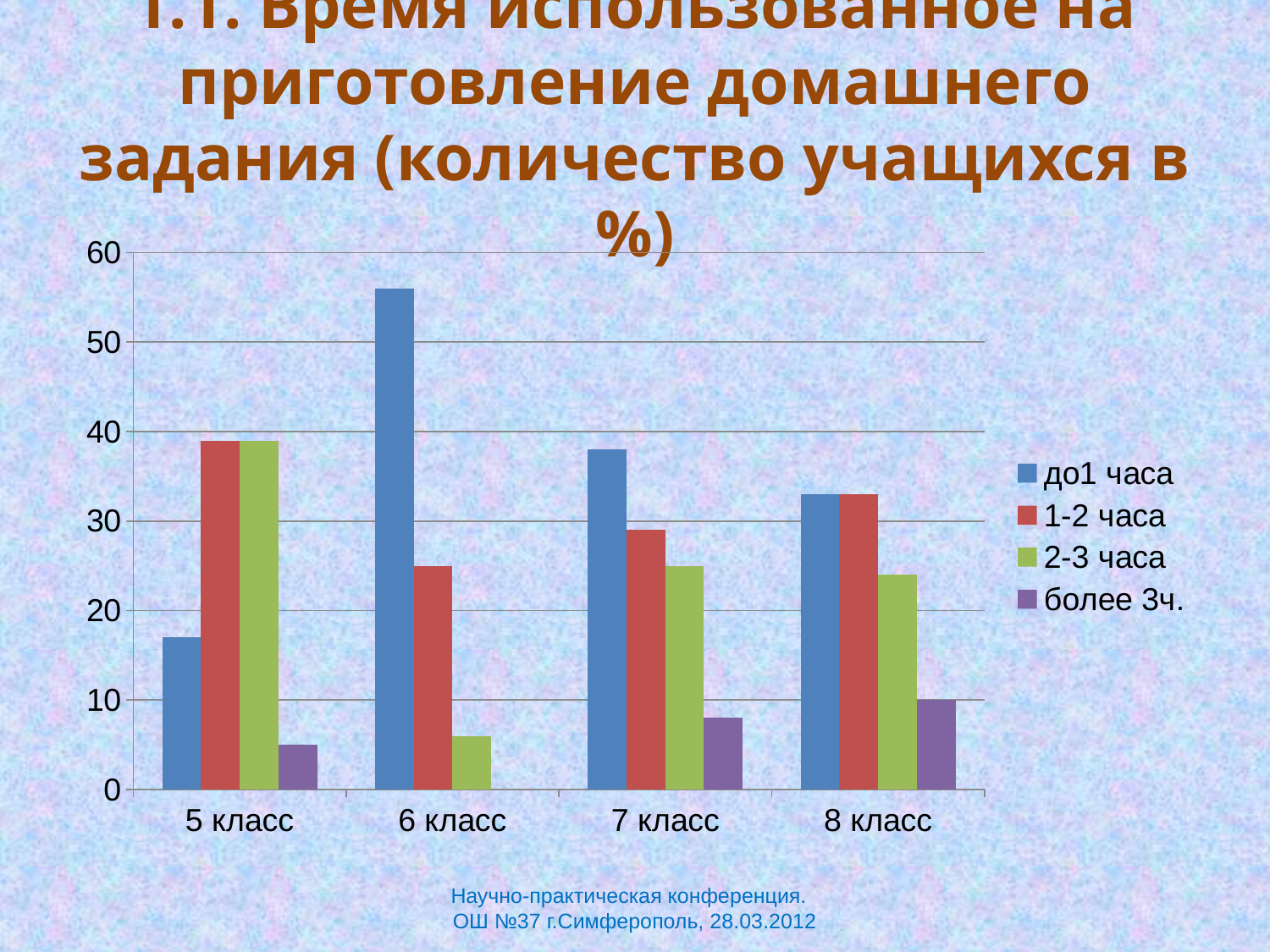
Is the value for "до1 часа" in 6 класс greater or less than 50? greater In 5 класс, which is larger: "до1 часа" or "1-2 часа"? 1-2 часа Which class has the lowest bar for "до1 часа"? 5 класс What kind of chart is shown on the slide? bar chart How many classes (categories) are shown on the x axis? 4 In 6 класс, which is larger: "до1 часа" or "1-2 часа"? до1 часа How many series does the legend list? 4 Which class has the lowest bar for "2-3 часа"? 6 класс Which class has the highest bar for "до1 часа"? 6 класс Is the value for "до1 часа" in 5 класс greater or less than 20? less Is the value for "2-3 часа" in 6 класс greater or less than 10? less Which legend entry is shown in purple? более 3ч.